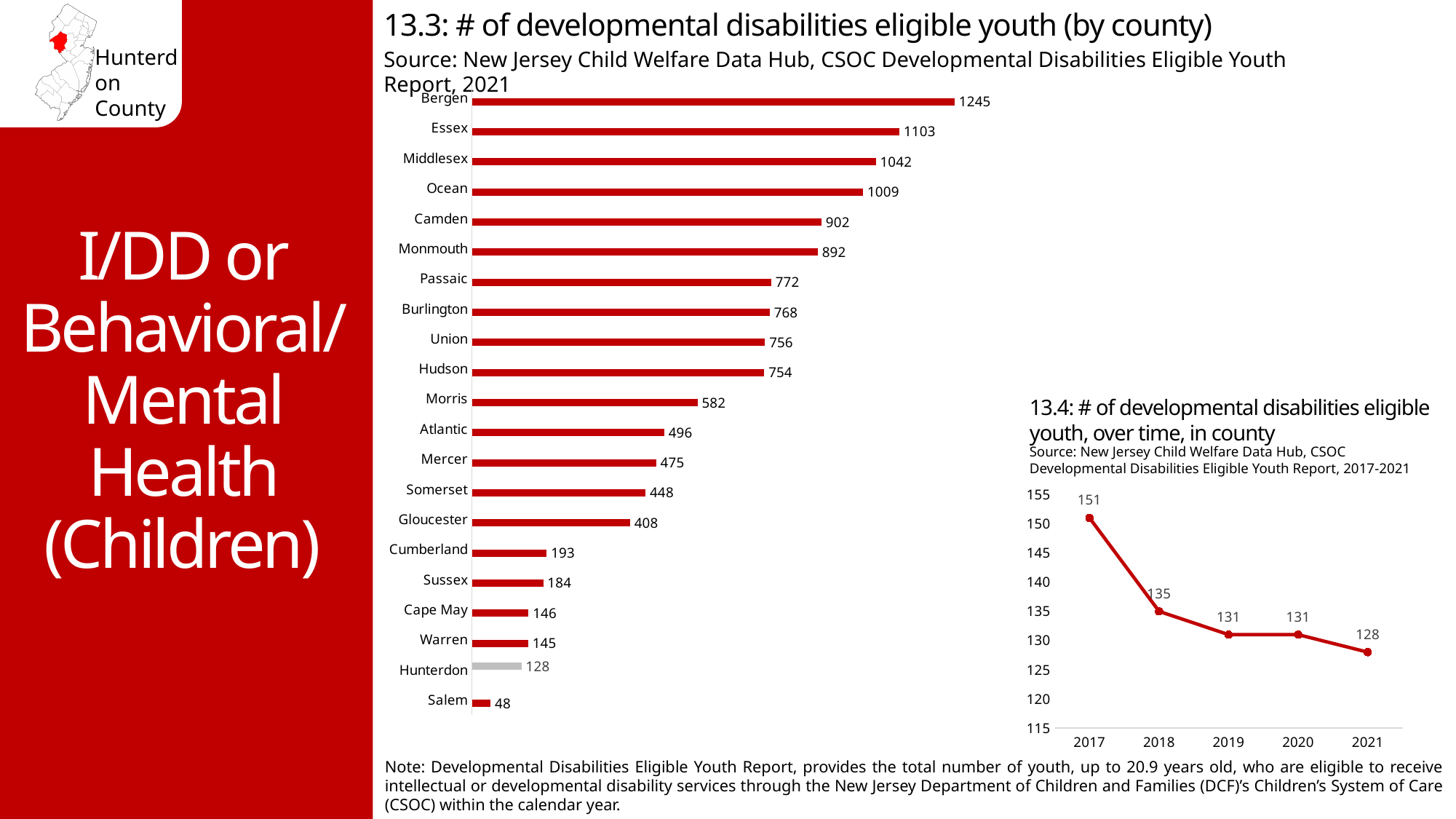
In the chart '13.3: # of developmental disabilities eligible youth (by county)', what is the value for Gloucester? 408 What kind of chart is '13.4: # of developmental disabilities eligible youth, over time, in county'? line chart In the chart '13.4: # of developmental disabilities eligible youth, over time, in county', what is the difference between the values for 2017 and 2021? 23 In the chart '13.3: # of developmental disabilities eligible youth (by county)', what is the value for Hunterdon? 128 In the chart '13.3: # of developmental disabilities eligible youth (by county)', which is larger, the value for Camden or the value for Monmouth? Camden In the chart '13.3: # of developmental disabilities eligible youth (by county)', which county has the lowest value? Salem In the chart '13.4: # of developmental disabilities eligible youth, over time, in county', what is the value for 2017? 151 In the chart '13.3: # of developmental disabilities eligible youth (by county)', how many counties are shown? 21 In the chart '13.3: # of developmental disabilities eligible youth (by county)', which county has the highest value? Bergen In the chart '13.3: # of developmental disabilities eligible youth (by county)', what is the difference between the values for Bergen and Essex? 142 What kind of chart is '13.3: # of developmental disabilities eligible youth (by county)'? bar chart In the chart '13.4: # of developmental disabilities eligible youth, over time, in county', do the values rise or fall from 2017 to 2021? fall